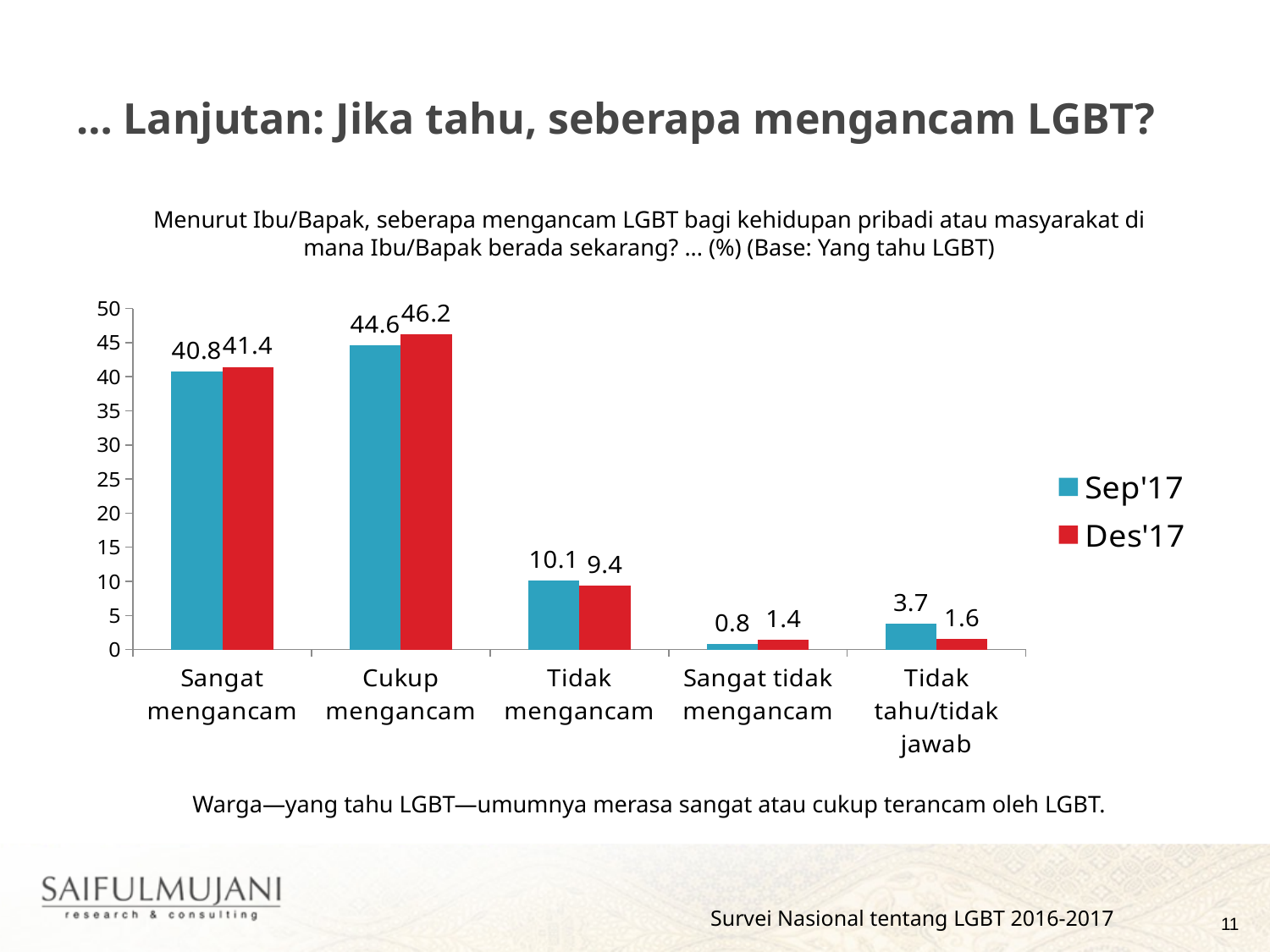
Which is larger for "Tidak mengancam": the Sep'17 value or the Des'17 value? Sep'17 Which category has the lowest Sep'17 value? Sangat tidak mengancam What kind of chart is shown on the slide? Bar chart What is the Sep'17 value for "Tidak tahu/tidak jawab"? 3.7 What is the Sep'17 value for "Sangat mengancam"? 40.8 Which colour represents the Des'17 series in the legend? Red What is the difference between the Sep'17 and Des'17 values for "Tidak tahu/tidak jawab"? 2.1 What is the Des'17 value for "Cukup mengancam"? 46.2 Which category has the highest Des'17 value? Cukup mengancam What is the difference between the Des'17 and Sep'17 values for "Cukup mengancam"? 1.6 How many categories are shown on the x axis? 5 How many series does the legend list? 2